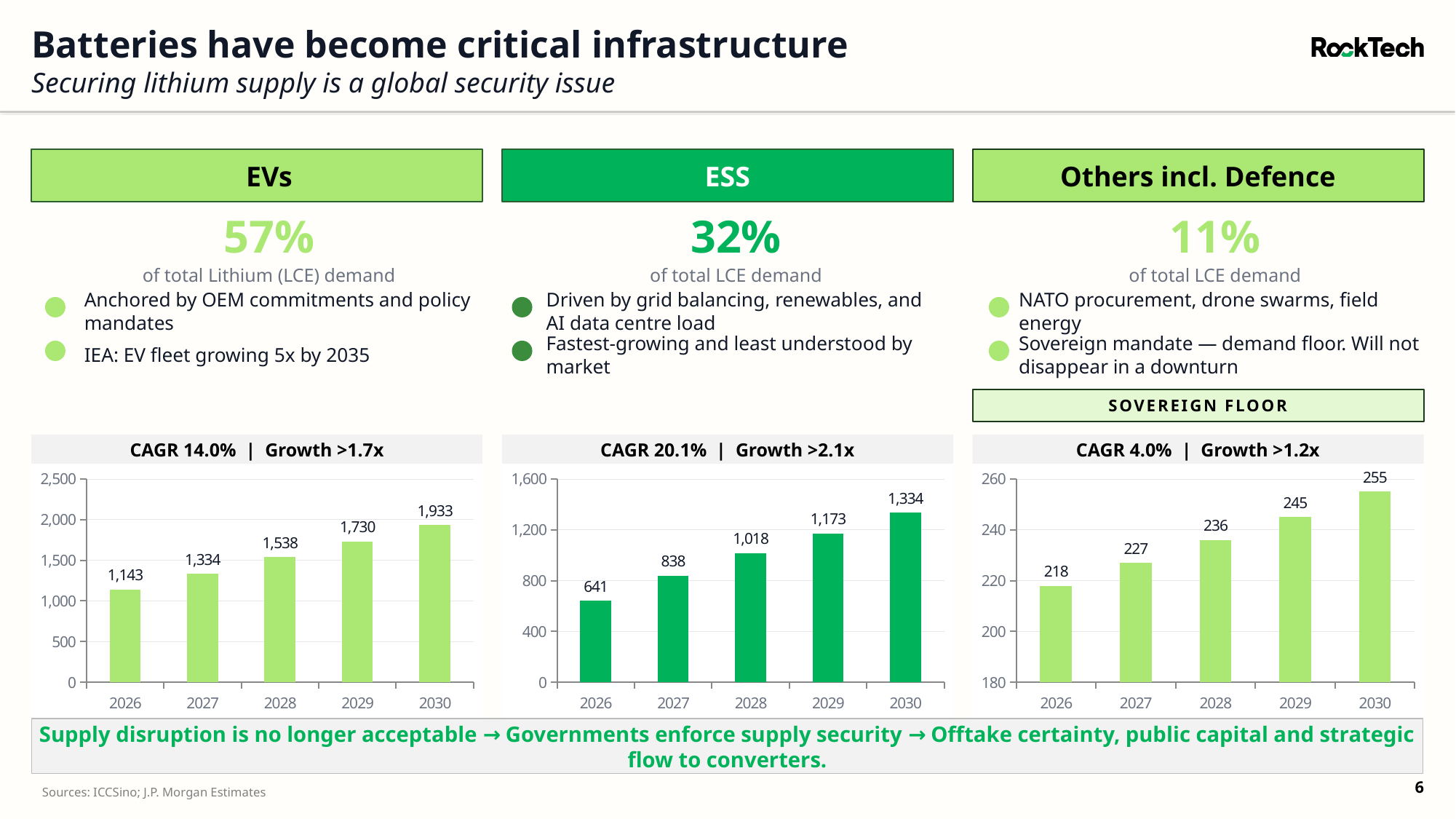
In the ESS chart, what is the value for 2026? 641 In the ESS chart, which year has the lowest value? 2026 In the ESS chart, what is the difference between the 2029 and 2028 values? 155 In the ESS chart, is the value for 2027 greater or less than 800? greater How many years are shown on the x axis of the EVs chart? 5 In the Others incl. Defence chart, do the values rise or fall from 2026 to 2030? rise In the Others incl. Defence chart, what is the value for 2029? 245 In the Others incl. Defence chart, which is larger, the value for 2027 or the value for 2028? 2028 What kind of chart is the ESS chart? bar chart In the EVs chart, what is the value for 2028? 1,538 In the EVs chart, which year has the highest value? 2030 In the EVs chart, what is the difference between the 2030 and 2026 values? 790